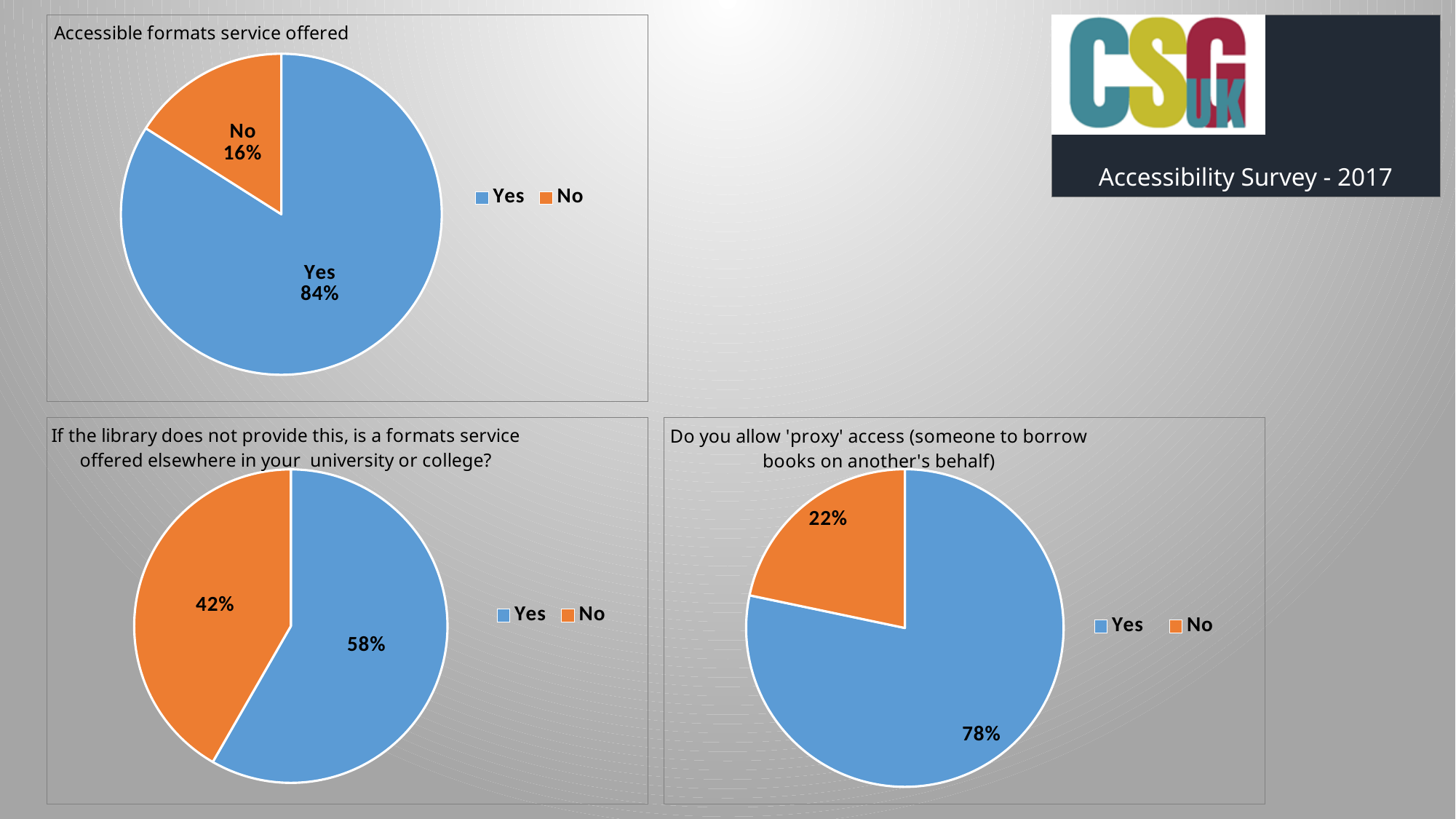
In the 'Accessible formats service offered' chart, what is the difference between the Yes and No percentages? 68% In the bottom-left chart, what is the difference between the Yes and No percentages? 16% In the 'Do you allow proxy access' chart, what percentage answered No? 22% In the 'Accessible formats service offered' chart, what percentage answered No? 16% In the 'Accessible formats service offered' chart, what percentage answered Yes? 84% In the 'Do you allow proxy access' chart, which response is the smallest slice? No In the chart titled 'If the library does not provide this, is a formats service offered elsewhere in your university or college?', what share is Yes? 58% What type of chart is used for 'Do you allow proxy access'? Pie chart In the 'Accessible formats service offered' chart, which response is the largest slice? Yes How many entries does the legend list in the 'Accessible formats service offered' chart? 2 In the chart titled 'If the library does not provide this, is a formats service offered elsewhere in your university or college?', what share is No? 42% In the 'Do you allow proxy access' chart, what percentage answered Yes? 78%